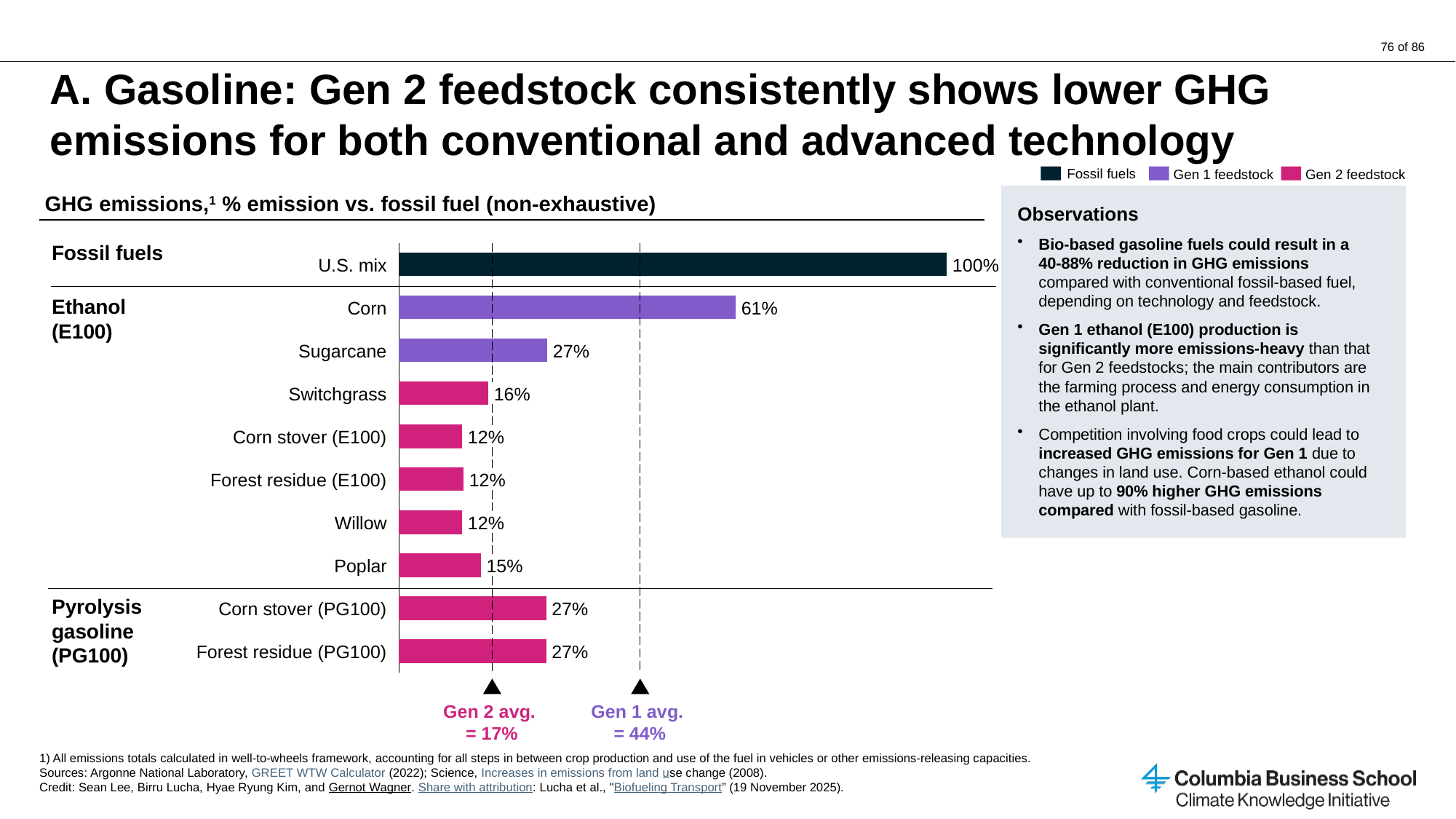
What is the GHG emissions value for Corn ethanol? 61% What is the GHG emissions value for Switchgrass? 16% Among the ethanol (E100) feedstocks, which has the highest GHG emissions value? Corn Which category has the highest GHG emissions value on the chart? U.S. mix What kind of chart is shown on the slide? Bar chart What is the difference between the GHG emissions values for Corn and Sugarcane? 34% How many entries does the legend list? 3 Which has a larger GHG emissions value, Switchgrass or Poplar? Switchgrass What is the GHG emissions value for Sugarcane? 27% What is the Gen 1 average GHG emissions value marked on the chart? 44% What is the GHG emissions value for Poplar? 15% How many bars are plotted on the chart? 10